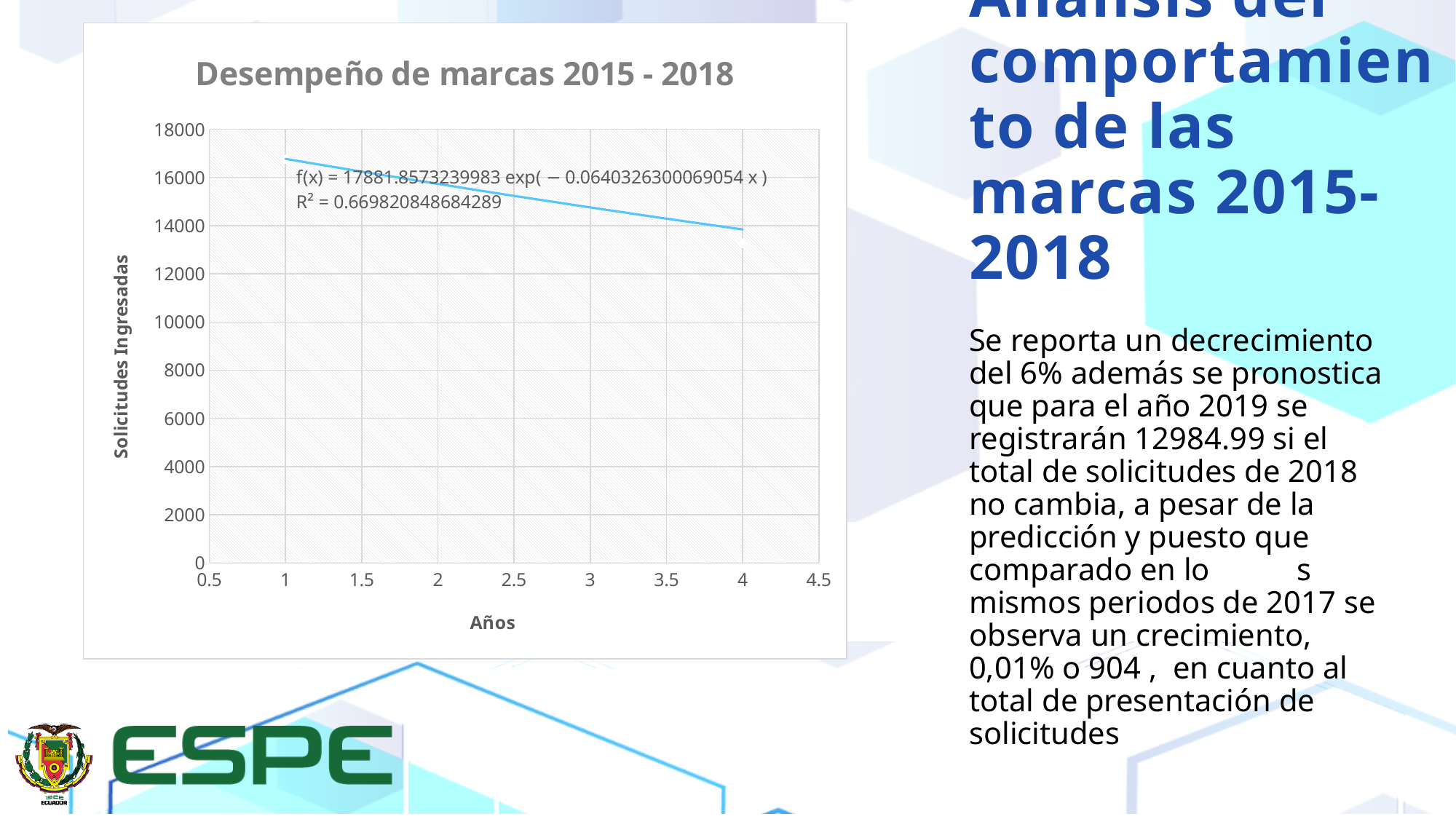
What is the highest tick value shown on the vertical axis? 18000 Is the value of the line at x = 1 greater or less than 16000? greater What R² value is printed on the chart? 0.669820848684289 What is the title of the chart? Desempeño de marcas 2015 - 2018 What is the coefficient in front of exp in the fitted equation printed on the chart? 17881.8573239983 Which point on the line is higher, the one at x = 1 or the one at x = 4? x = 1 Is the value of the line at x = 4 greater or less than 16000? less What is the label of the vertical axis of the chart? Solicitudes Ingresadas Do the values on the chart rise or fall as the x axis (Años) increases? fall Is the value of the line at x = 4 greater or less than 12000? greater What kind of chart is shown on the slide? line chart